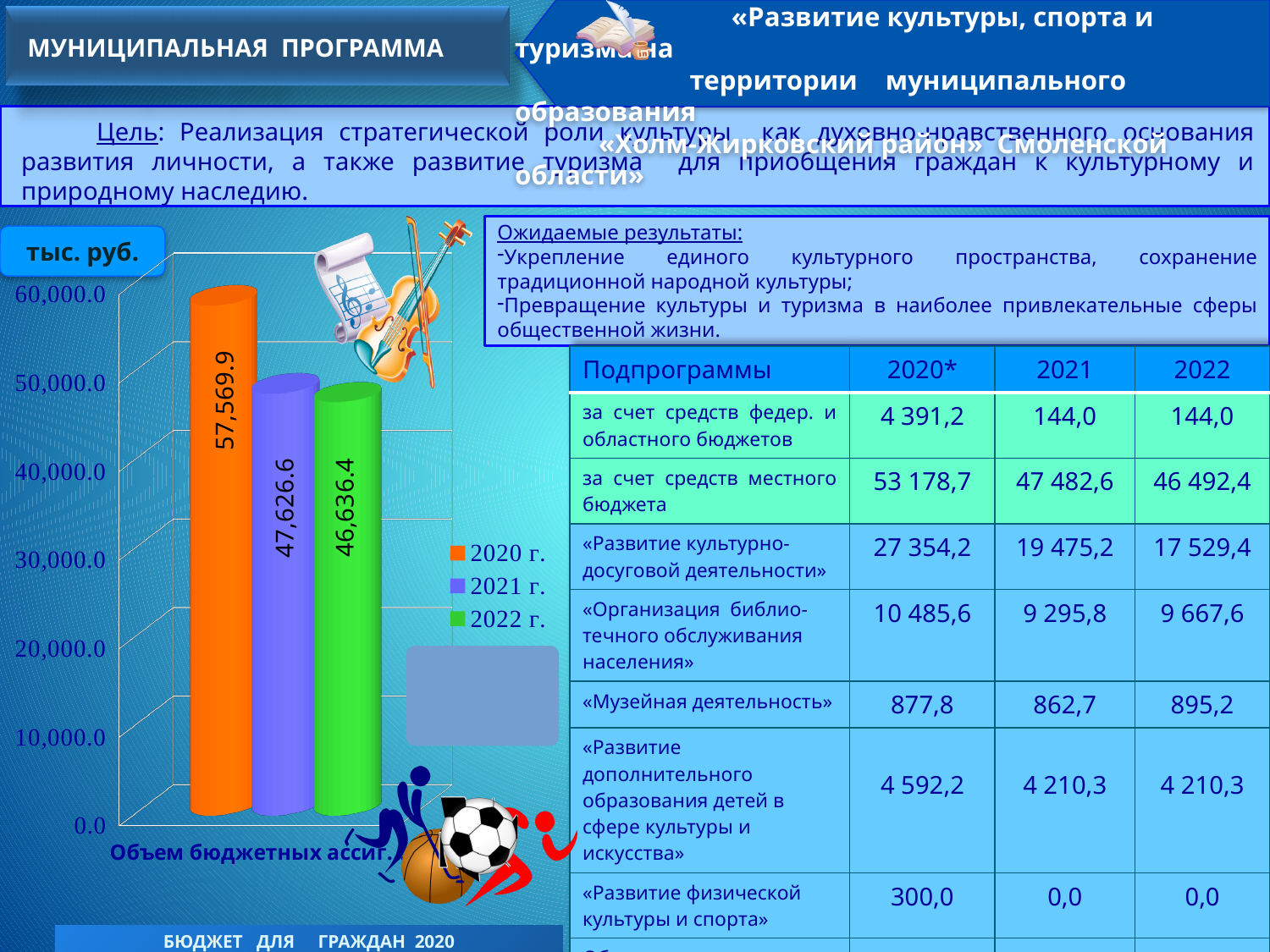
Do the values in the bar chart rise or fall from 2020 г. to 2022 г.? fall What kind of chart is shown on the left of the slide? bar chart Which is larger in the bar chart, the value for 2020 г. or the value for 2022 г.? 2020 г. Which year has the highest value in the bar chart? 2020 г. What is the value for 2021 г. in the bar chart? 47,626.6 What is the difference between the values for 2021 г. and 2022 г. in the bar chart? 990.2 Which year has the lowest value in the bar chart? 2022 г. Is the value for 2021 г. in the bar chart greater or less than 50,000.0? less What is the value for 2020 г. in the bar chart? 57,569.9 What is the difference between the values for 2020 г. and 2021 г. in the bar chart? 9,943.3 How many series does the legend of the bar chart list? 3 What is the value for 2022 г. in the bar chart? 46,636.4